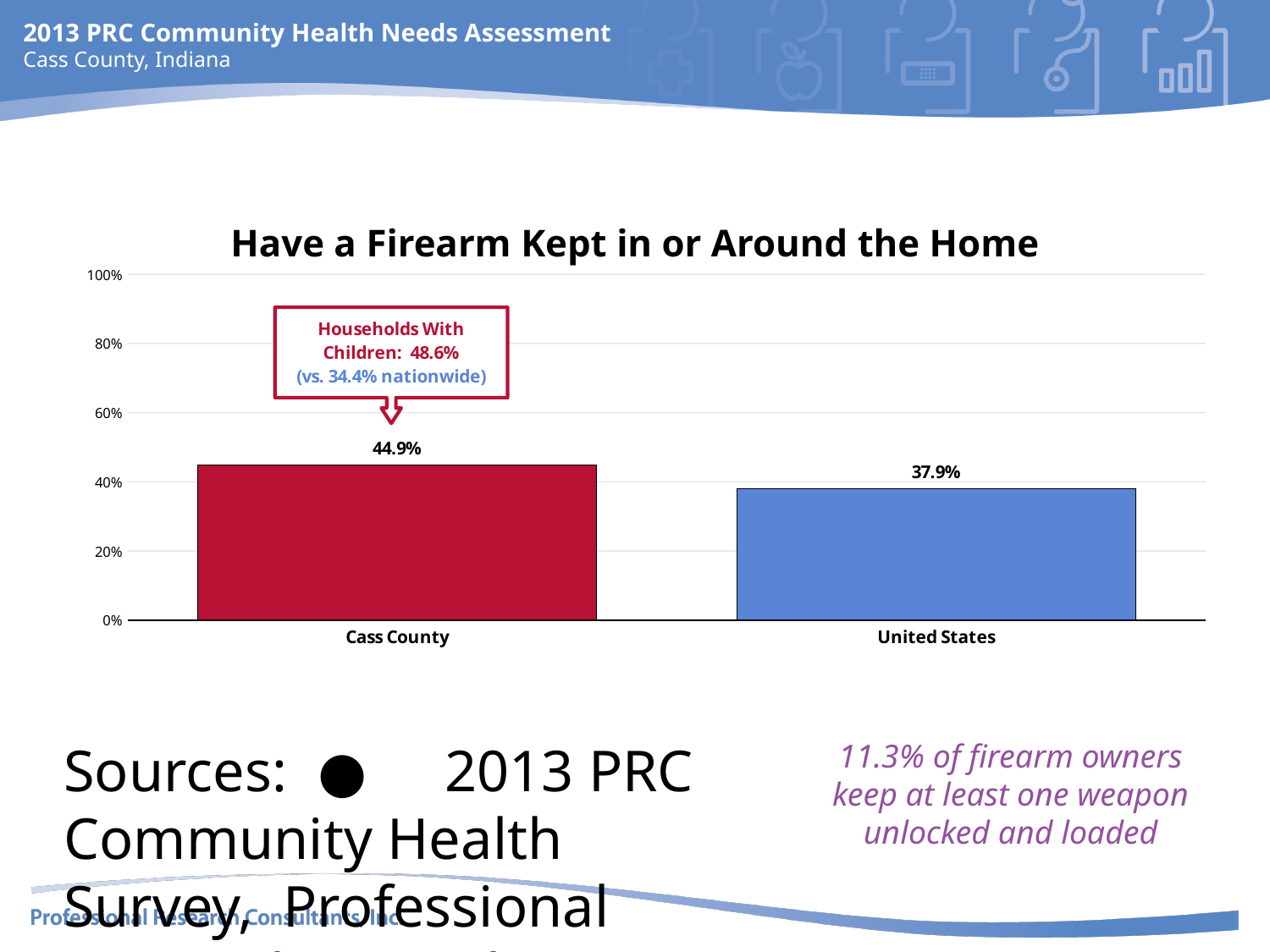
What kind of chart is shown? bar chart What is the value for Cass County? 44.9% What is the difference between the Cass County and United States values? 7.0% Which is larger, the value for Cass County or the value for United States? Cass County How many categories are shown in the chart? 2 Which category has the highest value? Cass County What is the value for United States? 37.9% Is the value for United States greater or less than 40%? less What is the title of the chart? Have a Firearm Kept in or Around the Home Is the value for Cass County greater or less than 40%? greater According to the callout on the chart, what is the value for households with children? 48.6% Which category has the lowest value? United States